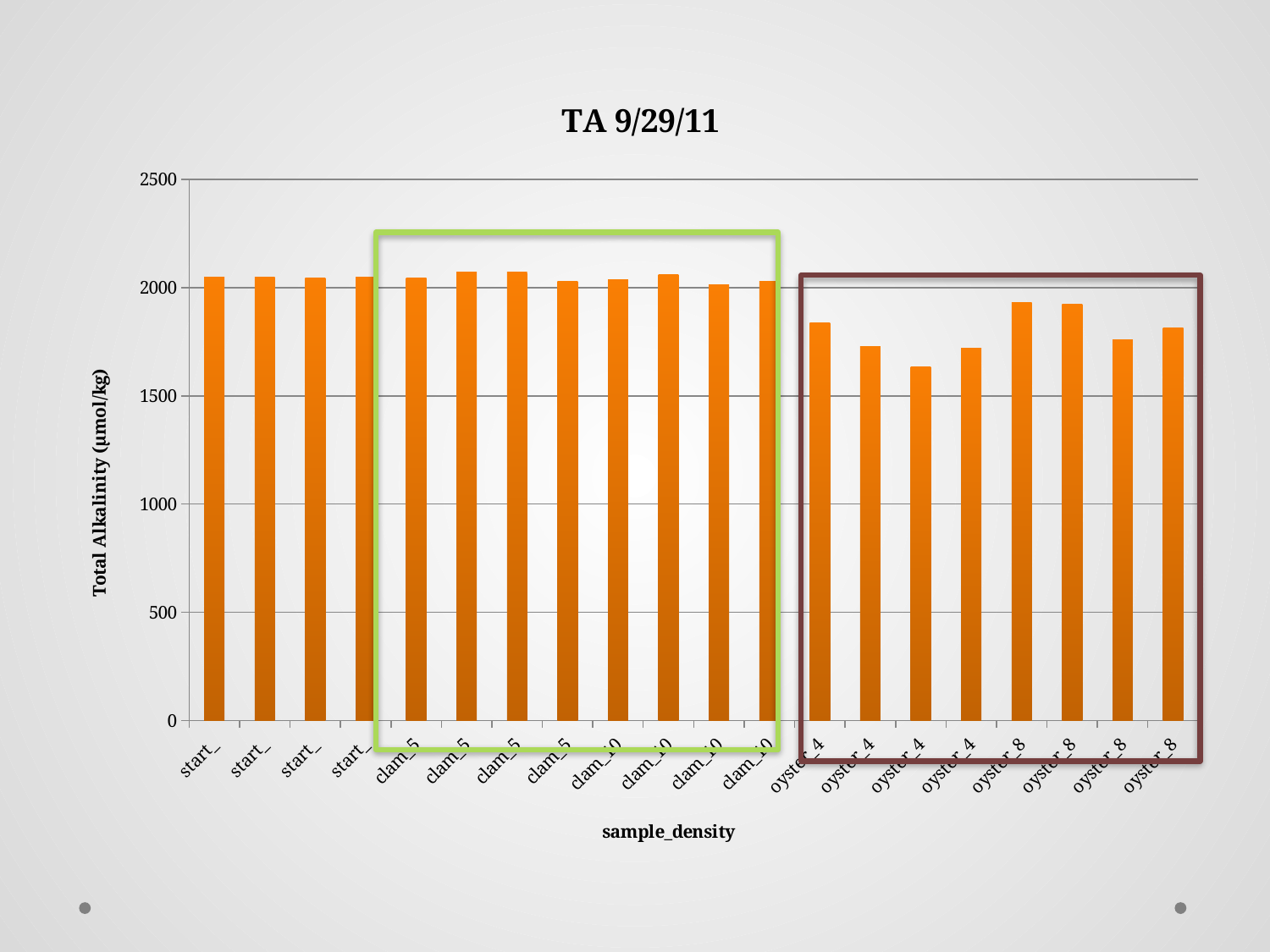
Which is larger, the first clam_5 bar or the first oyster_4 bar? clam_5 Are the oyster bars generally higher or lower than the clam bars? lower Is the value for the third oyster_4 bar greater or less than 1500? greater Is the value for the first start_ bar greater or less than 2000? greater Is the value for the third oyster_4 bar greater or less than 2000? less What is the label on the vertical axis of the chart? Total Alkalinity (µmol/kg) What is the title of the chart? TA 9/29/11 Which is larger, the first oyster_8 bar or the third oyster_4 bar? oyster_8 What kind of chart is shown on the slide? bar chart Which category label has the lowest bar in the chart? oyster_4 How many distinct category labels (sample_density groups) appear on the x axis? 5 How many bars are plotted in the chart? 20